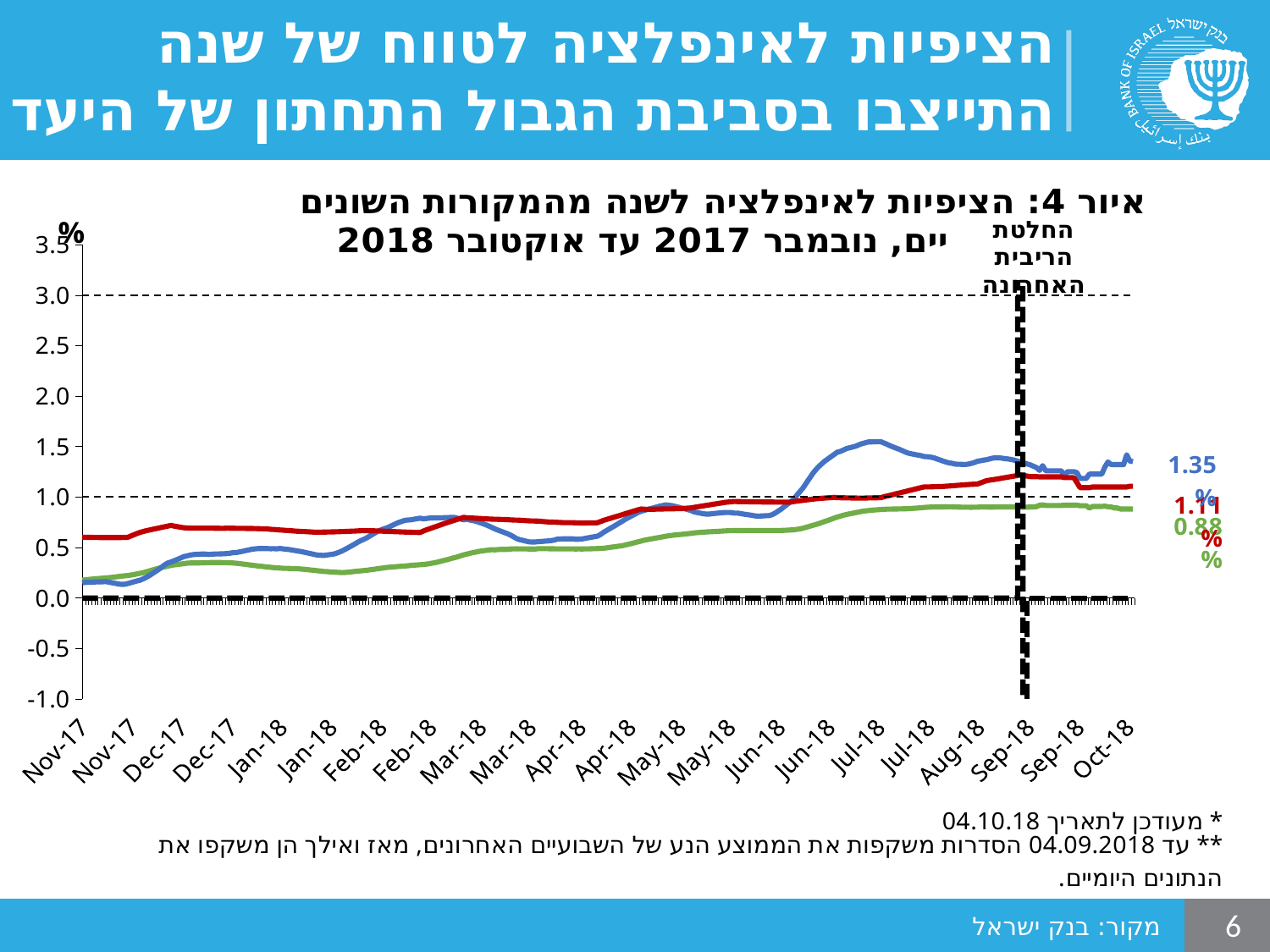
Does the green line rise or fall overall from Nov-17 to Oct-18? rises What is the final value labelled at the end of the green line? 0.88% What is the final value labelled at the end of the blue line? 1.35% Which line has the highest labelled end value? the blue line Is the value of the blue line around Jul-18 greater or less than 1.0? greater Which line has the lowest labelled end value? the green line How many lines are plotted on the chart? 3 What is the difference between the labelled end values of the blue line and the green line? 0.47 Is the labelled end value of the red line larger or smaller than that of the green line? larger What unit is shown at the top of the vertical axis? % What is the final value labelled at the end of the red line? 1.11% What kind of chart is shown on the slide? line chart